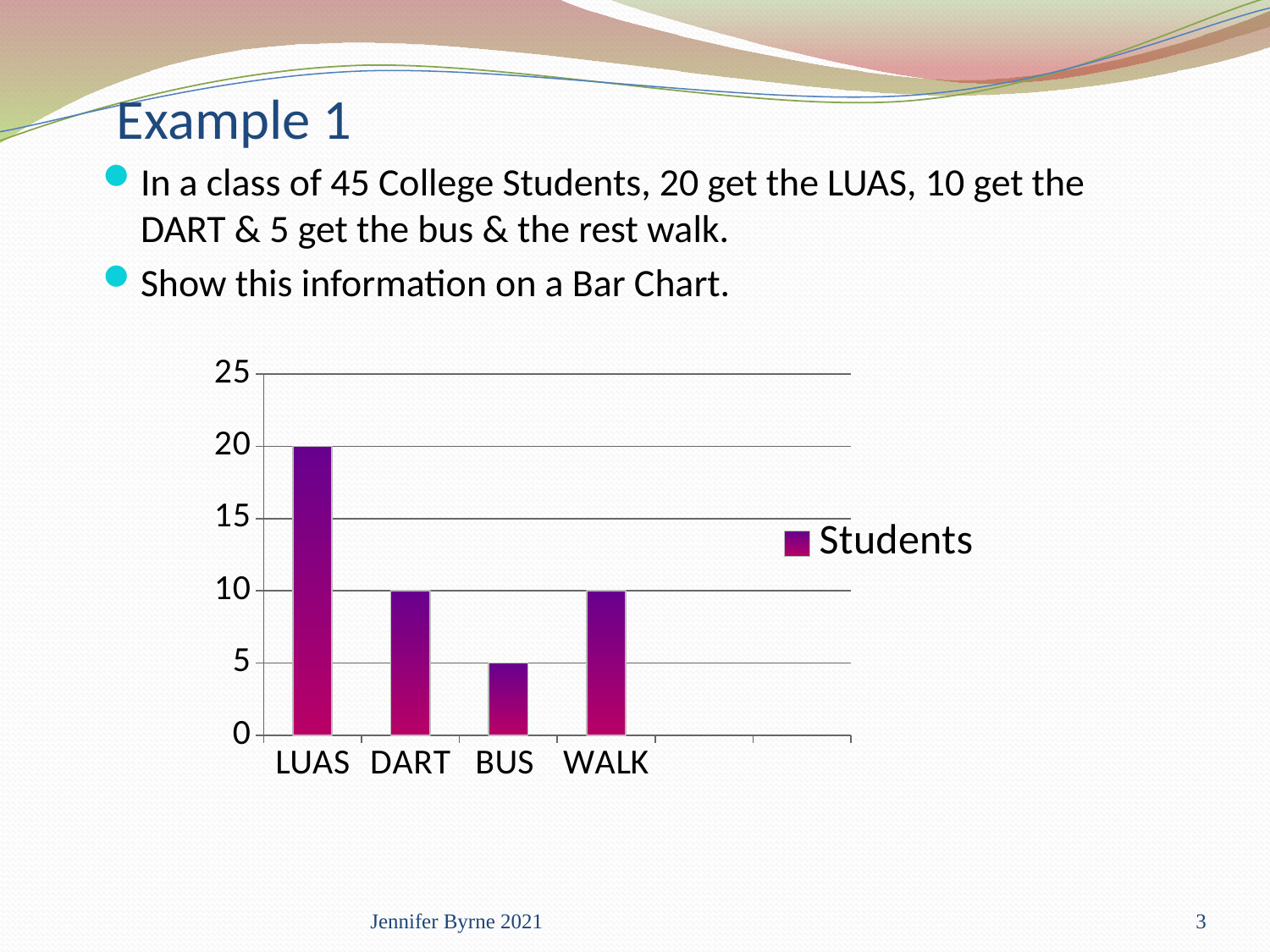
What is the difference between the values for LUAS and BUS? 15 Is the value for WALK greater or less than 15? less What is the value for BUS in the chart? 5 Which category has the lowest value in the chart? BUS How many categories are shown on the x axis of the chart? 4 What is the name of the series shown in the chart legend? Students How many series does the chart legend list? 1 What is the value for LUAS in the chart? 20 What kind of chart is shown on the slide? Bar chart Which is larger, the value for DART or the value for BUS? DART Which category has the highest value in the chart? LUAS What is the value for DART in the chart? 10